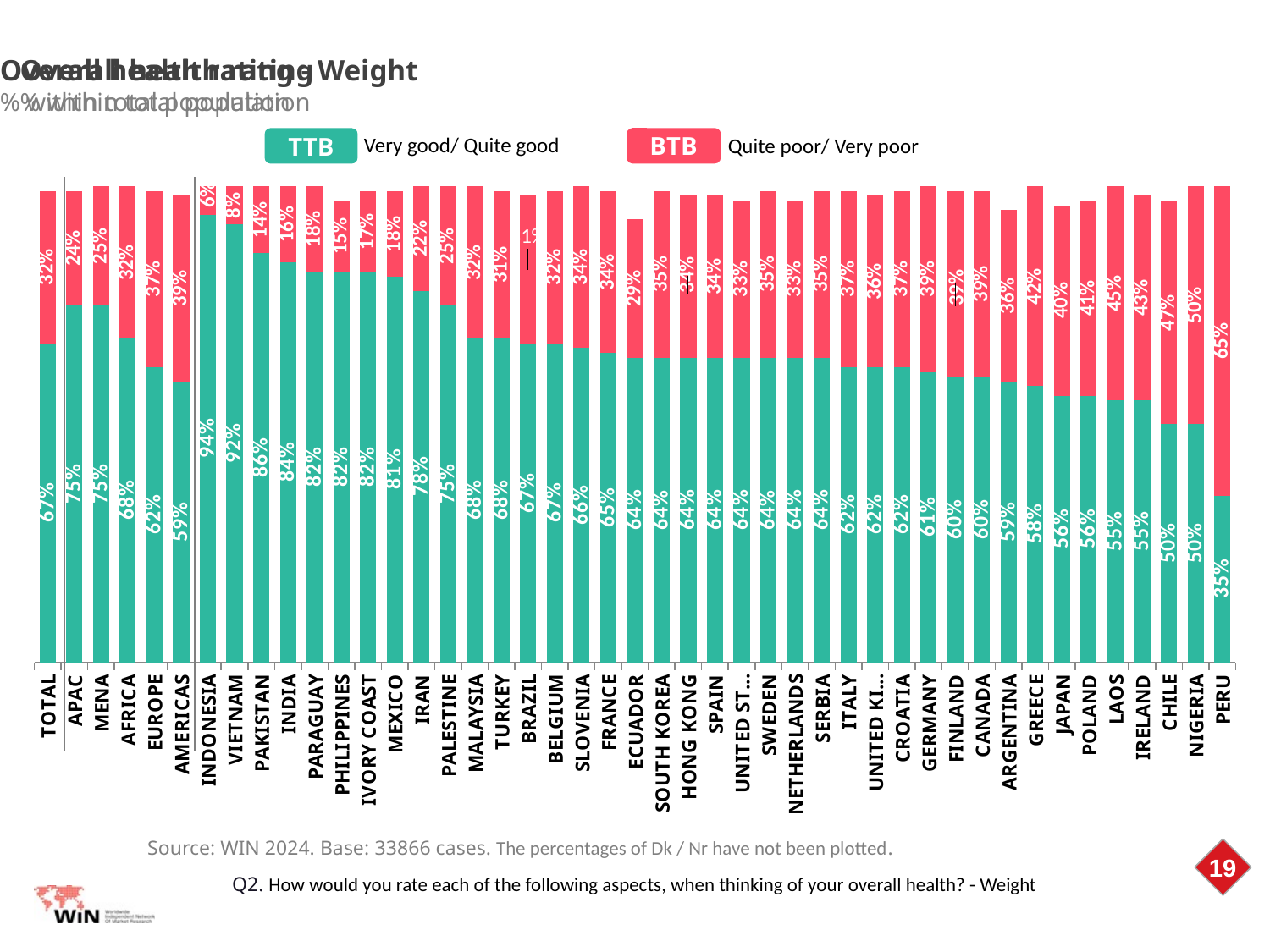
Which country has the highest TTB (Very good/ Quite good) value? Indonesia What is the total of the stacked bar for Indonesia (TTB plus BTB)? 100% Which country has the lowest TTB (Very good/ Quite good) value? Peru How many categories are shown on the x axis? 45 How many series does the legend list? 2 What is the difference between the TTB values for Vietnam and Japan? 36% What kind of chart is shown on the slide? Stacked bar chart What is the TTB (Very good/ Quite good) value for Indonesia? 94% What is the TTB value for TOTAL? 67% According to the legend, what does TTB stand for? Very good/ Quite good Which has a larger BTB value, Greece or Argentina? Greece What is the BTB (Quite poor/ Very poor) value for Peru? 65%